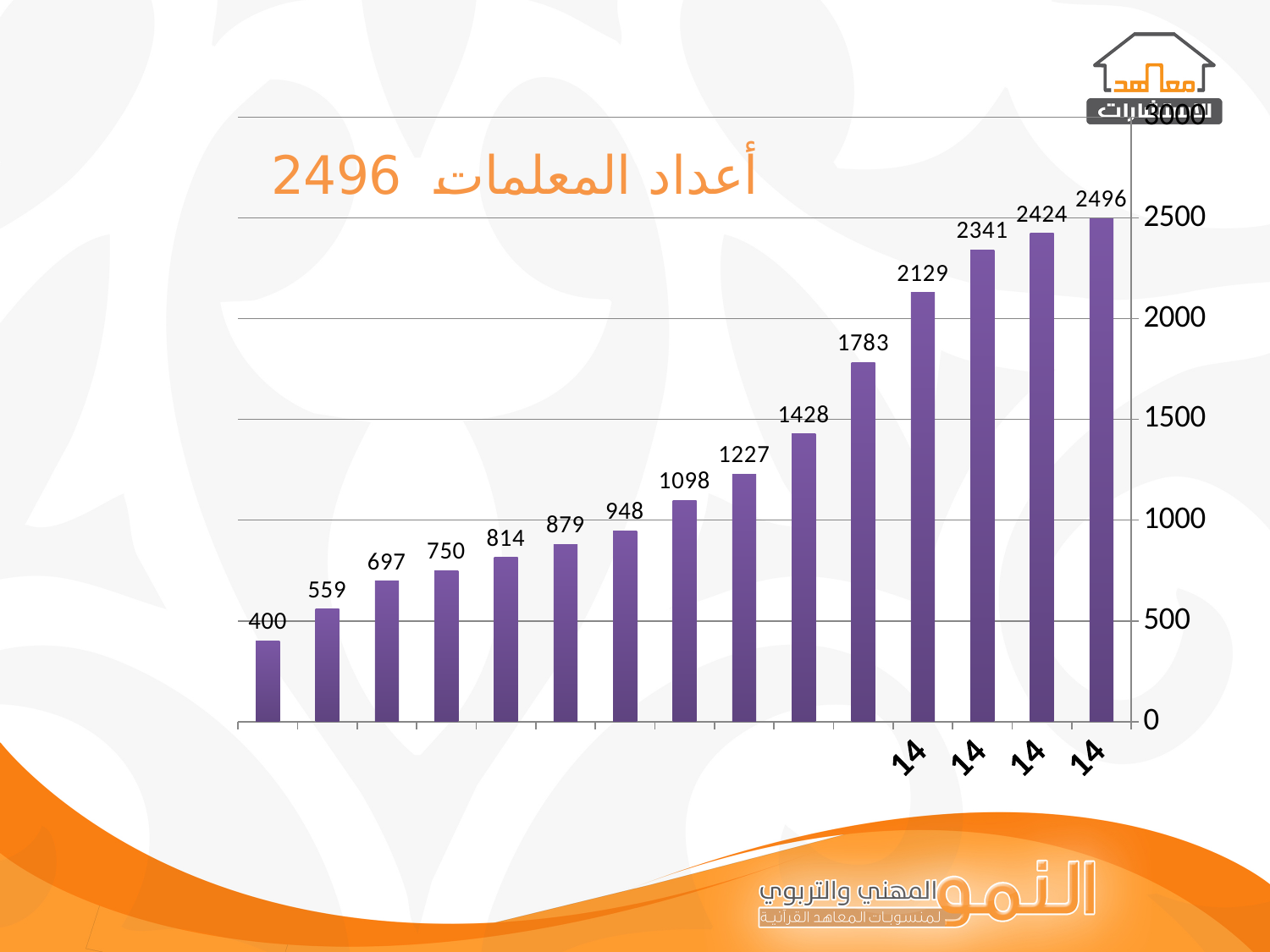
What kind of chart is shown on the slide? bar chart What is the difference between the rightmost bar (2496) and the leftmost bar (400)? 2096 Which bar has the highest value, and what is it? The rightmost bar, 2496 What is the value of the rightmost (last) bar? 2496 What is the value of the second bar from the left? 559 What is the value of the tenth bar from the left? 1428 How many bars are plotted in the chart? 15 What is the lowest value shown in the chart? 400 What is the value of the leftmost (first) bar? 400 What is the difference between the bars labelled 2129 and 1783? 346 What number appears in the chart title next to the Arabic text? 2496 Do the values rise or fall from left to right along the x axis? rise